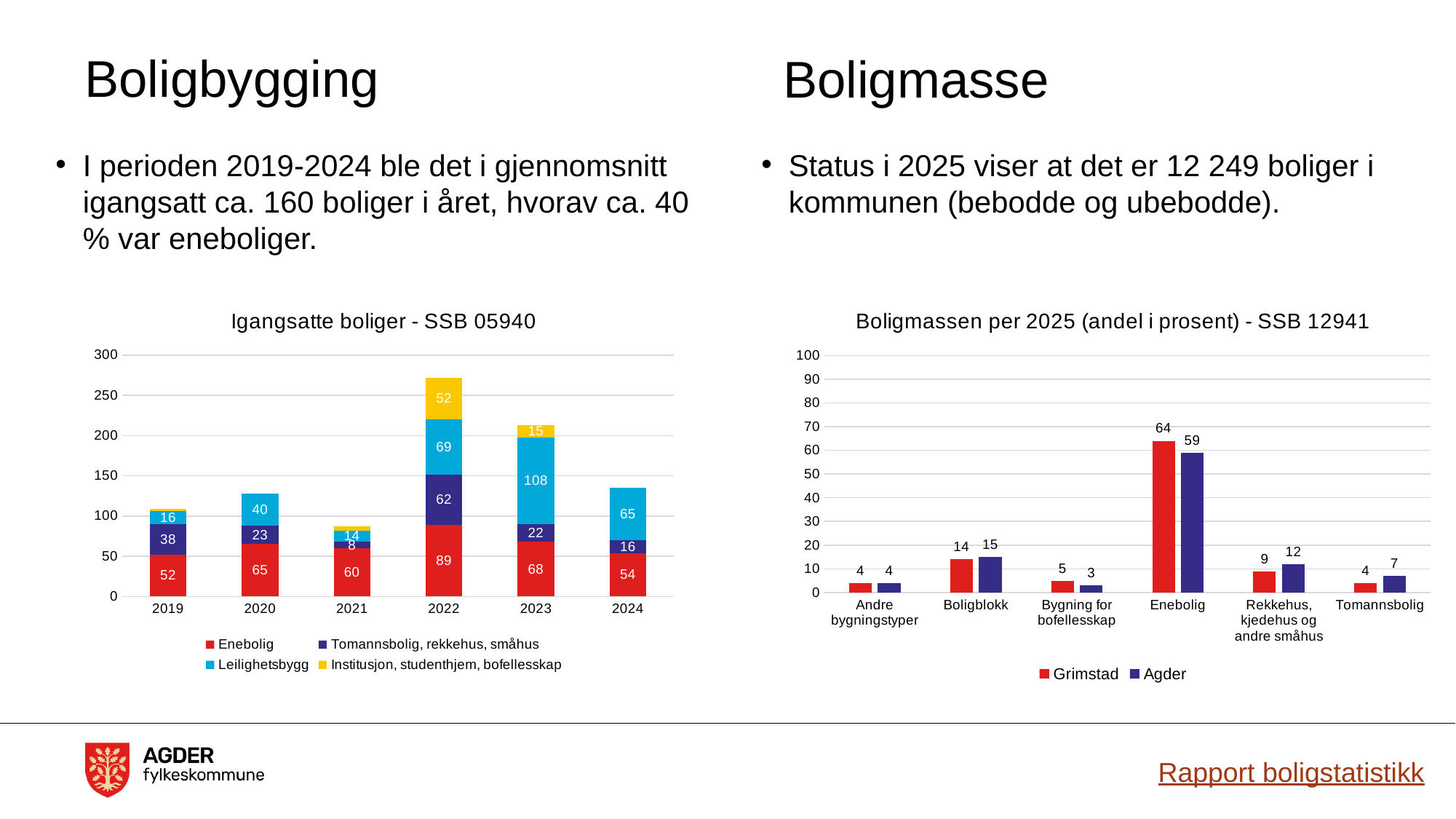
In the chart 'Igangsatte boliger - SSB 05940', how many series does the legend list? 4 In the chart 'Igangsatte boliger - SSB 05940', what is the Enebolig value for 2022? 89 In the chart 'Igangsatte boliger - SSB 05940', what is the difference between the Enebolig values for 2022 and 2024? 35 In the chart 'Boligmassen per 2025 (andel i prosent) - SSB 12941', how many categories are shown on the x axis? 6 In the chart 'Boligmassen per 2025 (andel i prosent) - SSB 12941', what is the Agder value for Rekkehus, kjedehus og andre småhus? 12 In the chart 'Igangsatte boliger - SSB 05940', what is the Leilighetsbygg value for 2023? 108 What kind of chart is 'Boligmassen per 2025 (andel i prosent) - SSB 12941'? Bar chart In the chart 'Boligmassen per 2025 (andel i prosent) - SSB 12941', which category has the highest Grimstad value? Enebolig In the chart 'Igangsatte boliger - SSB 05940', which year has the highest total stacked bar? 2022 In the chart 'Igangsatte boliger - SSB 05940', what is the total of the stacked bar for 2022? 272 In the chart 'Boligmassen per 2025 (andel i prosent) - SSB 12941', is the Grimstad value or the Agder value larger for Tomannsbolig? Agder In the chart 'Boligmassen per 2025 (andel i prosent) - SSB 12941', what is the Grimstad value for Enebolig? 64